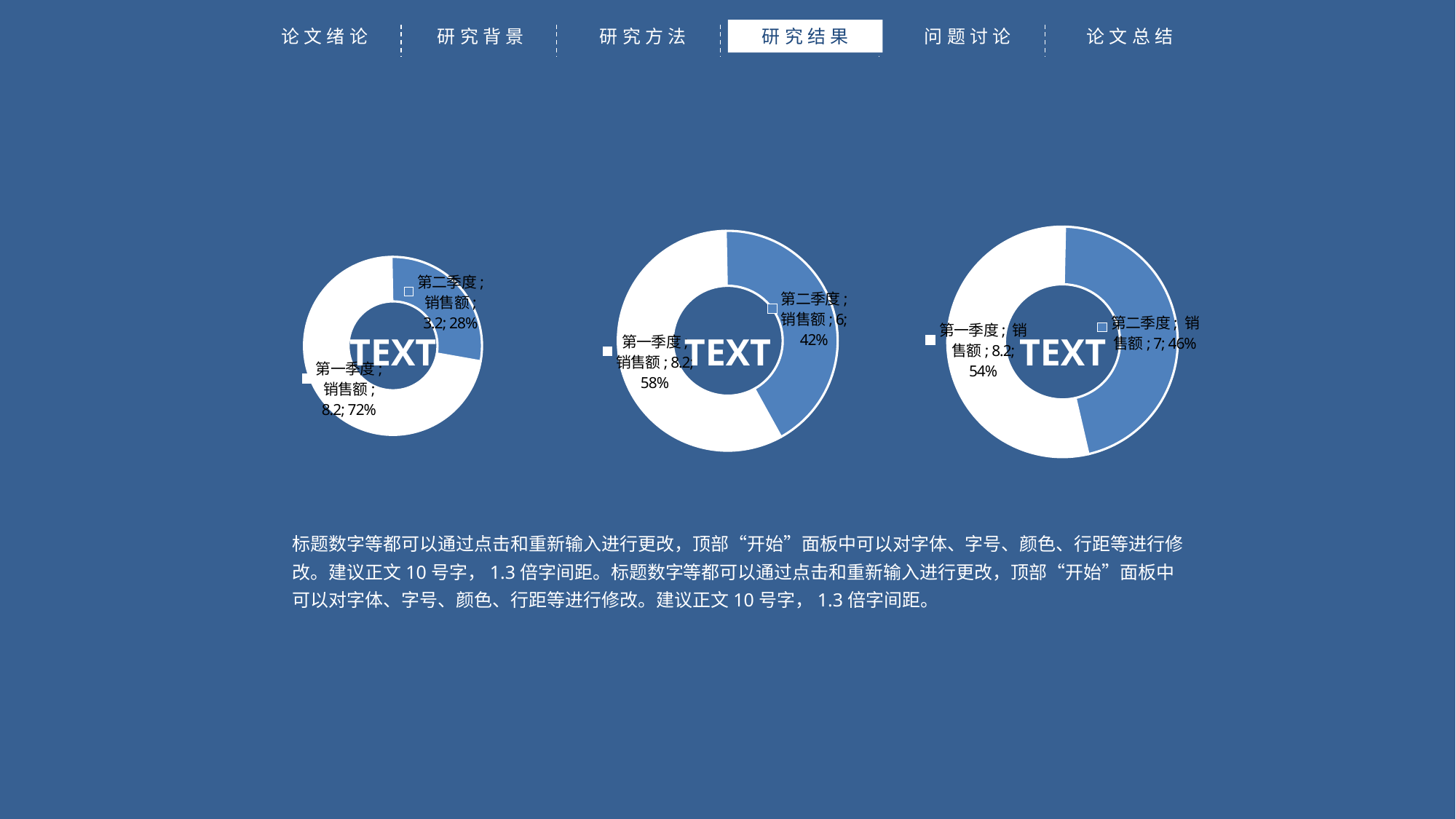
In the middle doughnut chart, what is the 销售额 value for 第二季度? 6 In the right doughnut chart, which quarter has the smaller 销售额? 第二季度 What type of chart is shown in the middle of the slide? Doughnut chart In the left doughnut chart, what is the difference between the 销售额 of 第一季度 and 第二季度? 5 In the right doughnut chart, what is the 销售额 value for 第二季度? 7 In the middle doughnut chart, what percentage share does 第一季度 have? 58% In the left doughnut chart, what percentage share does 第二季度 have? 28% In the right doughnut chart, what percentage share does 第二季度 have? 46% In the left doughnut chart, which quarter has the larger 销售额? 第一季度 In the middle doughnut chart, what is the difference between the 销售额 of 第一季度 and 第二季度? 2.2 How many slices does the right doughnut chart have? 2 In the left doughnut chart, what is the 销售额 value for 第一季度? 8.2